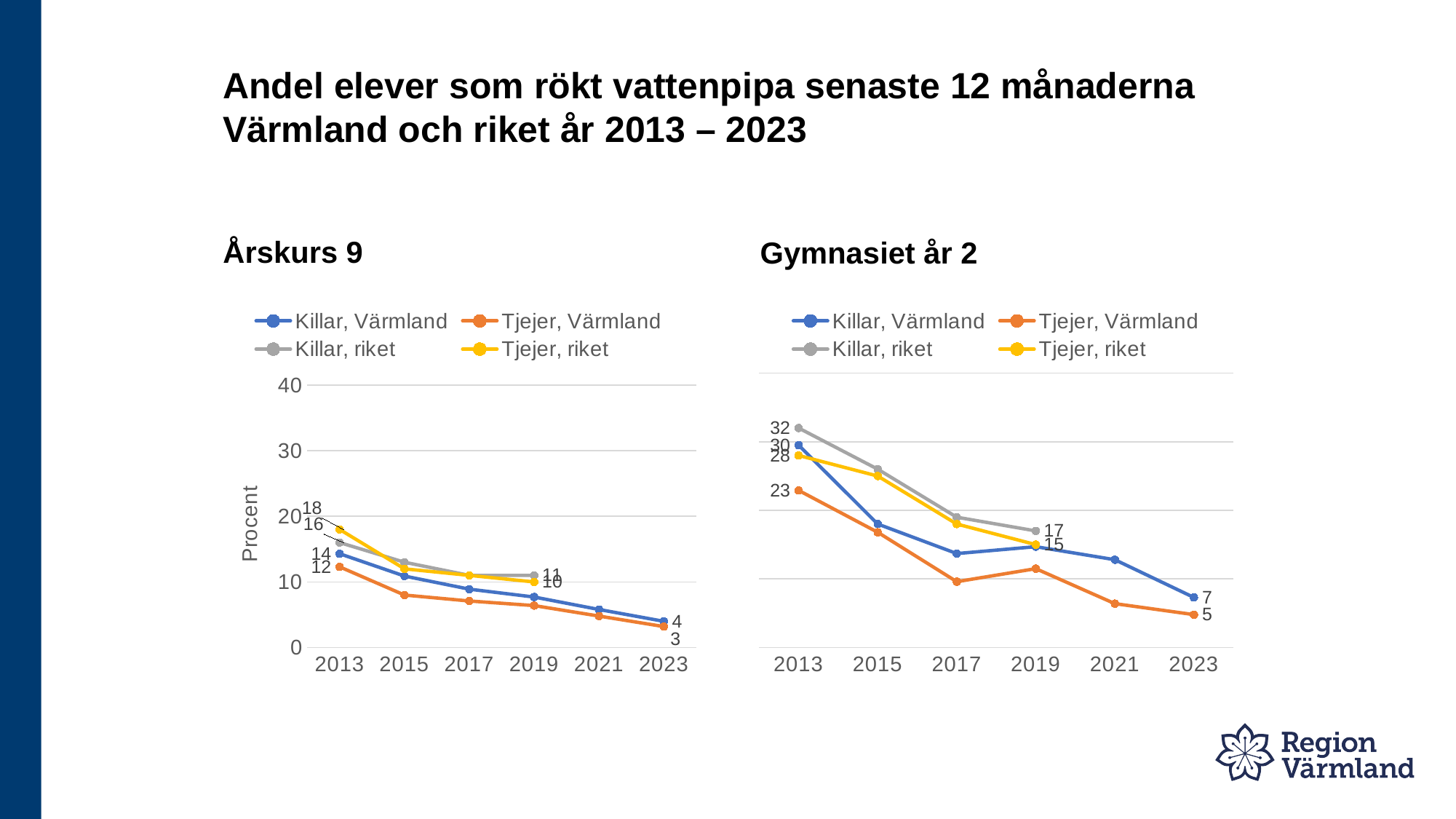
In the Gymnasiet år 2 chart, what is the value for Killar, riket in 2013? 32 In the Årskurs 9 chart, what is the value for Killar, Värmland in 2023? 4 How many series does the legend of the Gymnasiet år 2 chart list? 4 In the Årskurs 9 chart, which is larger in 2019: Killar, riket or Tjejer, riket? Killar, riket In the Årskurs 9 chart, what is the value for Tjejer, riket in 2013? 18 In the Gymnasiet år 2 chart, which series has the highest value in 2013? Killar, riket In the Gymnasiet år 2 chart, what is the value for Tjejer, Värmland in 2023? 5 In the Gymnasiet år 2 chart, what is the difference between Killar, Värmland and Tjejer, Värmland in 2023? 2 In the Årskurs 9 chart, which series has the lowest value in 2013? Tjejer, Värmland In the Gymnasiet år 2 chart, do the values for Tjejer, Värmland generally rise or fall from 2013 to 2023? fall In the Årskurs 9 chart, is the value for Killar, Värmland in 2015 greater or less than 20? less What type of chart is the Årskurs 9 chart? line chart